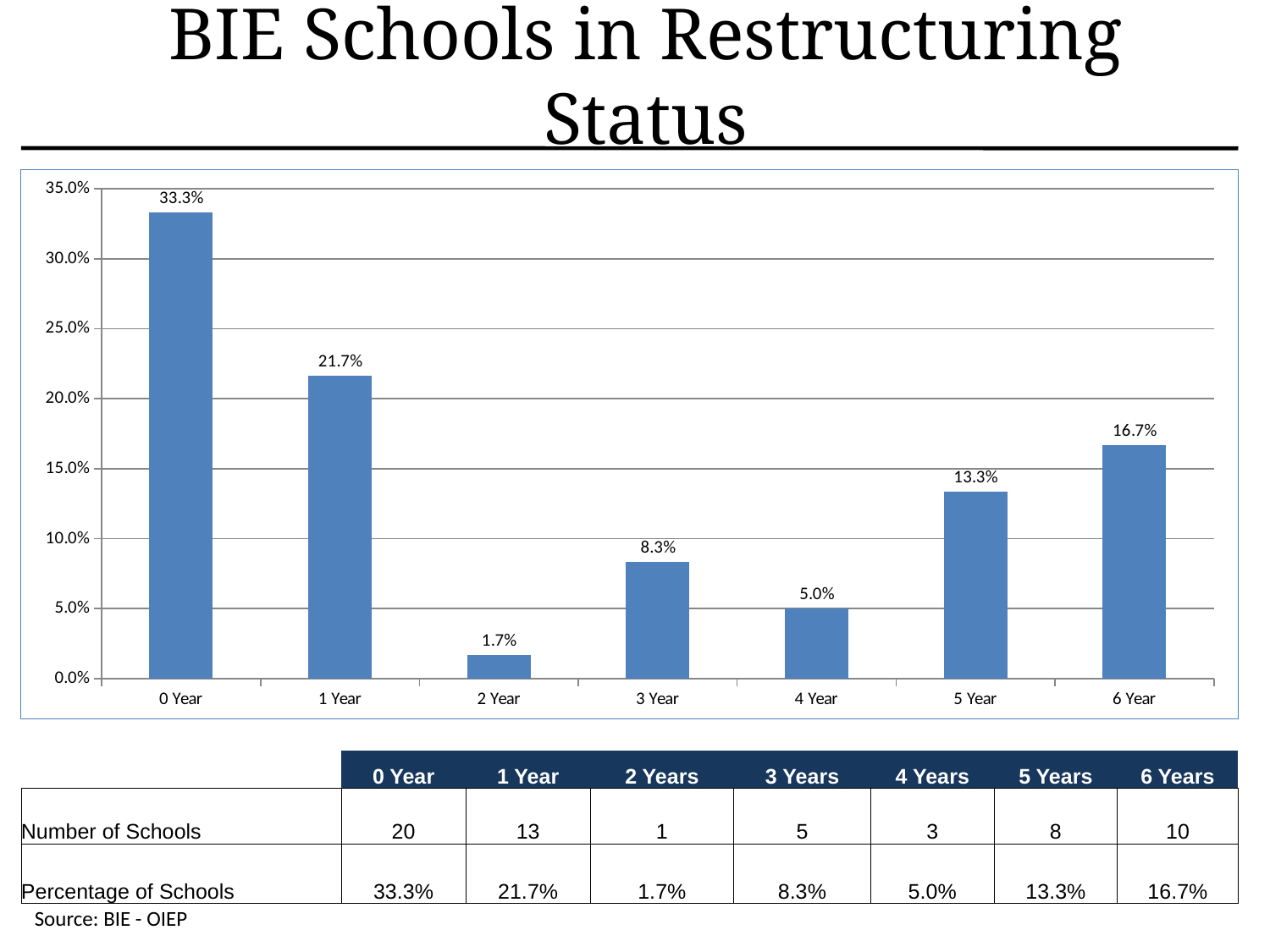
How many categories are shown on the x axis? 7 Which category has the lowest value? 2 Year What is the difference between the values for 6 Year and 5 Year? 3.4% What is the value for 3 Year? 8.3% Which is larger, the value for 4 Year or the value for 6 Year? 6 Year What is the title of the slide containing the chart? BIE Schools in Restructuring Status What kind of chart is shown on the slide? bar chart What is the value for 0 Year? 33.3% What is the difference between the values for 0 Year and 1 Year? 11.6% Which category has the highest value? 0 Year What is the value for 5 Year? 13.3% Is the value for 1 Year greater or less than 20.0%? greater